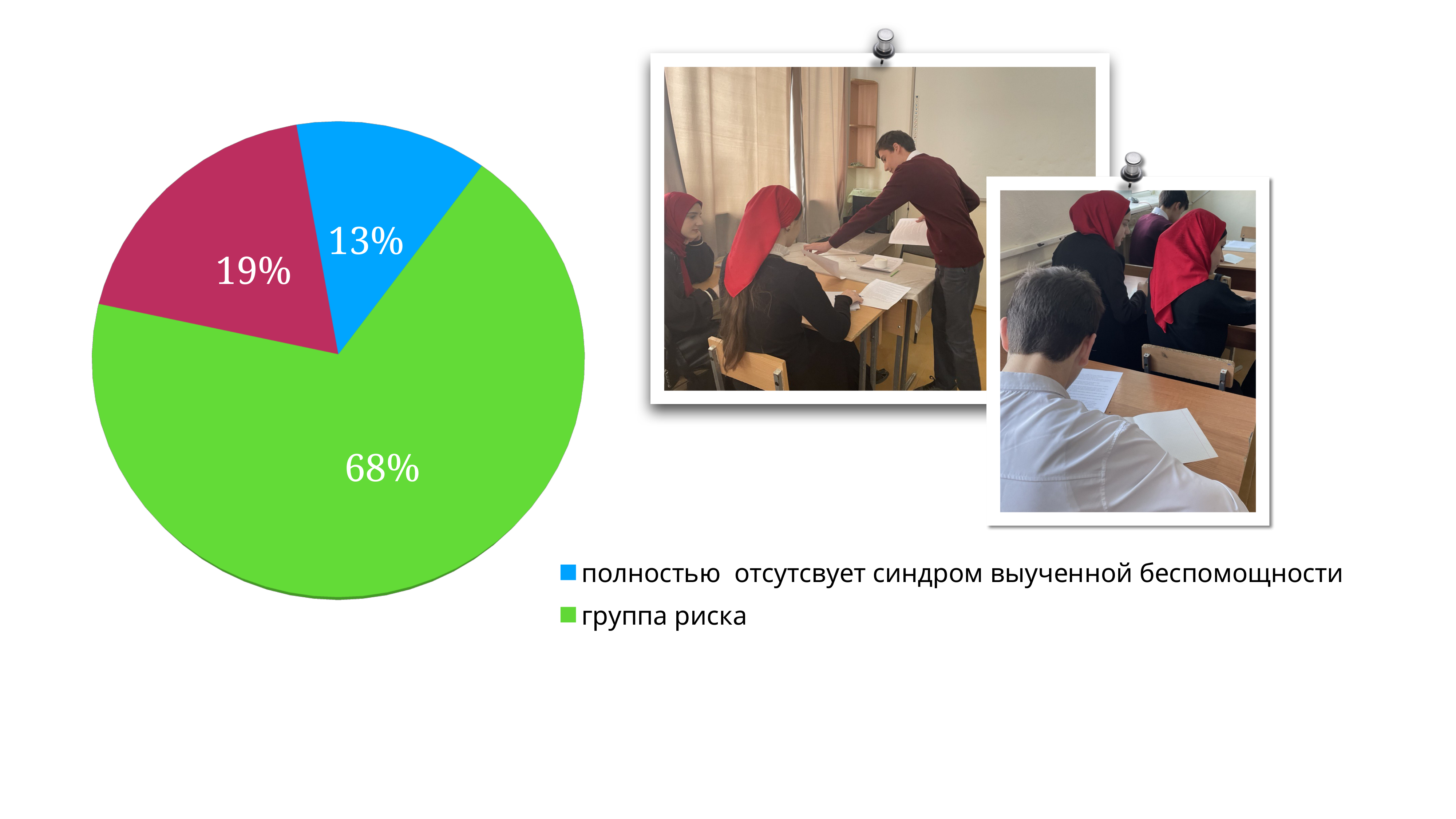
What share of the pie does "группа риска" take? 68% Which is larger: the slice for "группа риска" or the slice labelled 19%? группа риска How many entries does the legend list? 2 What is the difference in percentage points between the "группа риска" slice and the "полностью отсутсвует синдром выученной беспомощности" slice? 55 Which legend category has the smallest slice of the pie? полностью отсутсвует синдром выученной беспомощности What colour is the "группа риска" slice? green What is the difference in percentage points between the 68% slice and the 19% slice? 49 Which legend category has the largest slice of the pie? группа риска What kind of chart is shown on the slide? pie chart What colour is the slice labelled 13%? blue What percentage is shown for "полностью отсутсвует синдром выученной беспомощности"? 13% How many slices does the pie chart have? 3